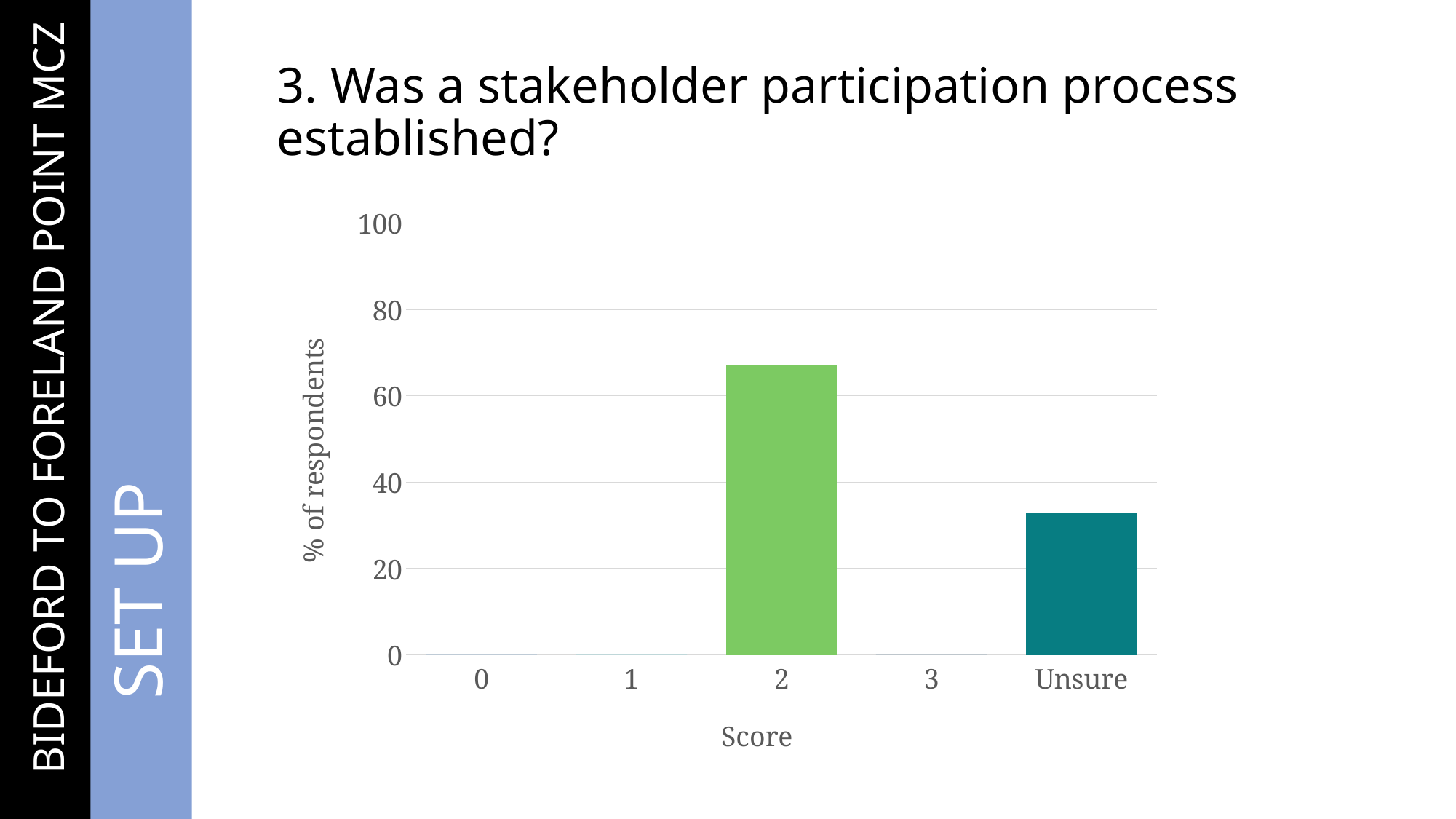
Is the value for Unsure greater or less than 40? less Is the value for score 1 greater or less than 20? less What is the label of the y axis of the chart? % of respondents How many score categories are shown on the x axis of the chart? 5 Which score category has the highest percentage of respondents? 2 Which has a larger percentage of respondents, score 2 or Unsure? 2 Is the value for Unsure greater or less than 20? greater What is the label of the x axis of the chart? Score What kind of chart is shown on the slide? bar chart